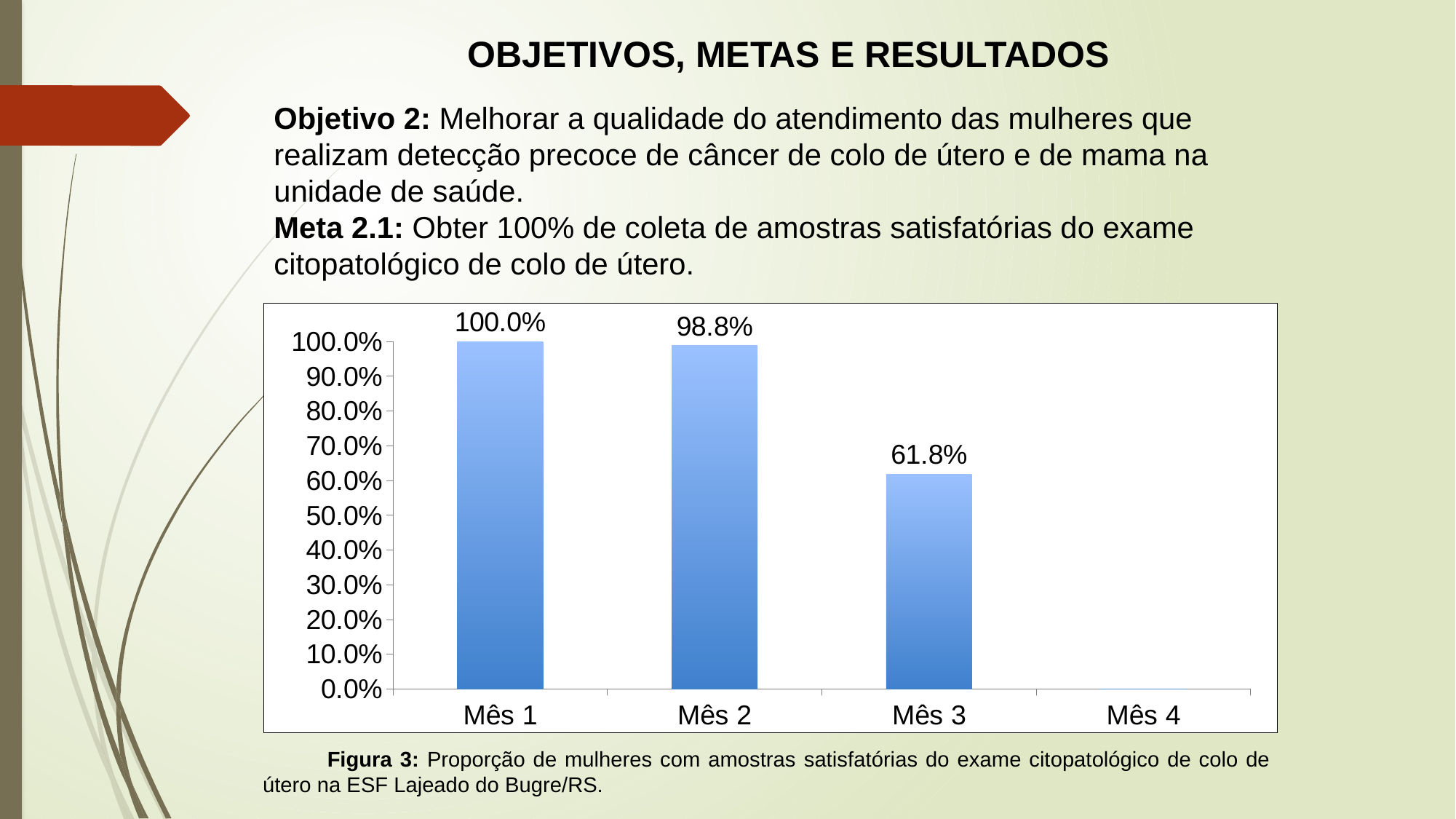
Do the values rise or fall from Mês 1 to Mês 3? fall Is the value for Mês 3 greater or less than 70.0%? less What is the value for Mês 2? 98.8% What is the value for Mês 1? 100.0% Which month has the highest value? Mês 1 What is the difference between the values for Mês 1 and Mês 3? 38.2% What is the difference between the values for Mês 2 and Mês 3? 37.0% What is the value for Mês 3? 61.8% What is the figure number given in the caption below the chart? Figura 3 What kind of chart is shown on the slide? bar chart Which is larger, the value for Mês 2 or the value for Mês 3? Mês 2 How many months are shown on the x axis? 4